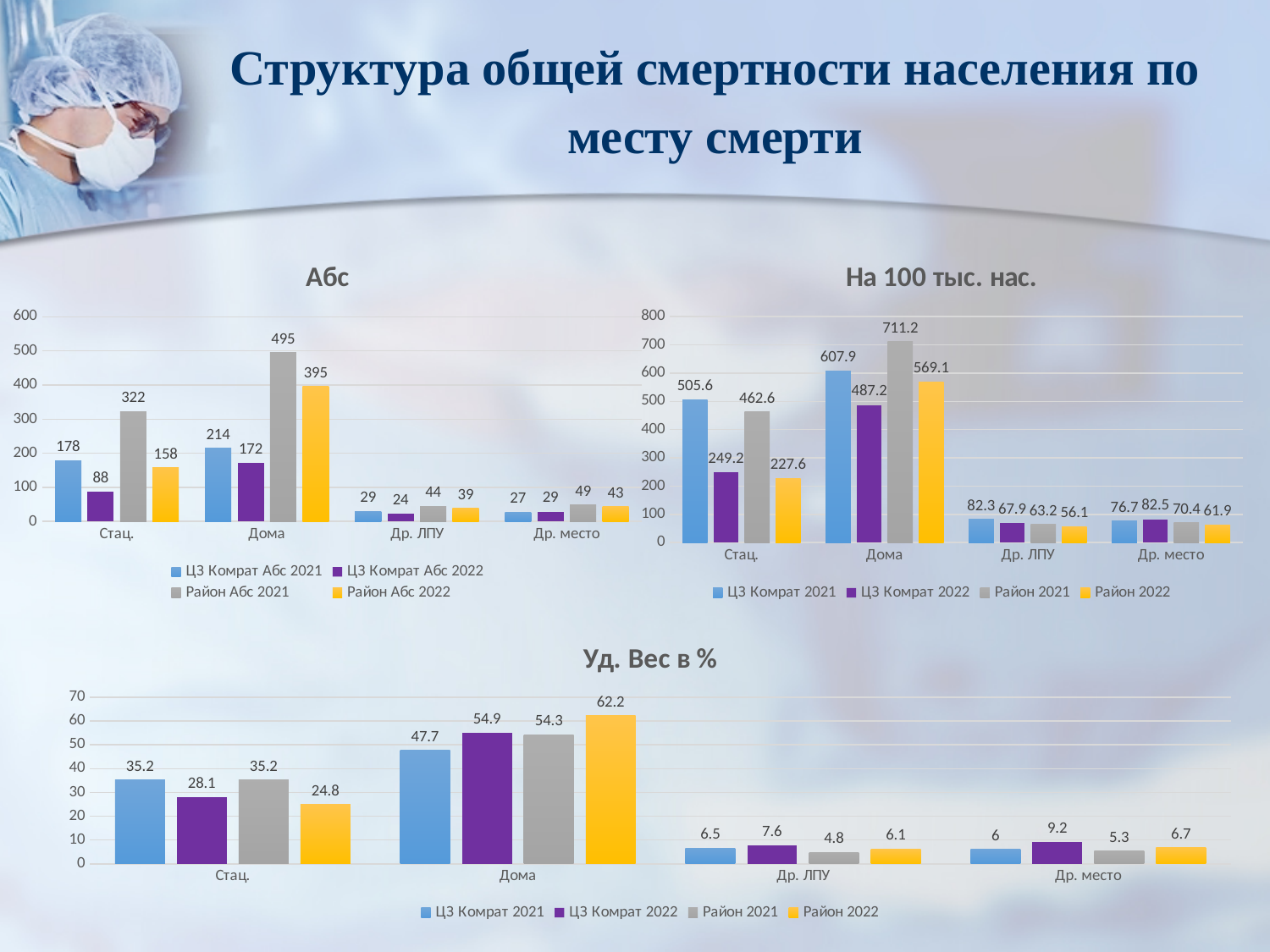
In the "Абс" chart, how many series does the legend list? 4 In the "На 100 тыс. нас." chart, which is larger in the Стац. category: ЦЗ Комрат 2021 or Район 2021? ЦЗ Комрат 2021 In the "Абс" chart, what is the difference between Район Абс 2021 and Район Абс 2022 in the Стац. category? 164 In the "Уд. Вес в %" chart, which category has the highest value for ЦЗ Комрат 2022? Дома In the "Абс" chart, what is the value for Район Абс 2021 in the Дома category? 495 What type of chart is the "Уд. Вес в %" chart? Bar chart In the "На 100 тыс. нас." chart, how many categories are shown on the x axis? 4 In the "Уд. Вес в %" chart, what is the value for Район 2022 in the Дома category? 62.2 In the "На 100 тыс. нас." chart, which category has the lowest value for ЦЗ Комрат 2021? Др. место In the "Абс" chart, what is the value for ЦЗ Комрат Абс 2022 in the Стац. category? 88 In the "На 100 тыс. нас." chart, what is the value for Район 2021 in the Дома category? 711.2 In the "Уд. Вес в %" chart, what is the difference between ЦЗ Комрат 2021 and ЦЗ Комрат 2022 in the Стац. category? 7.1